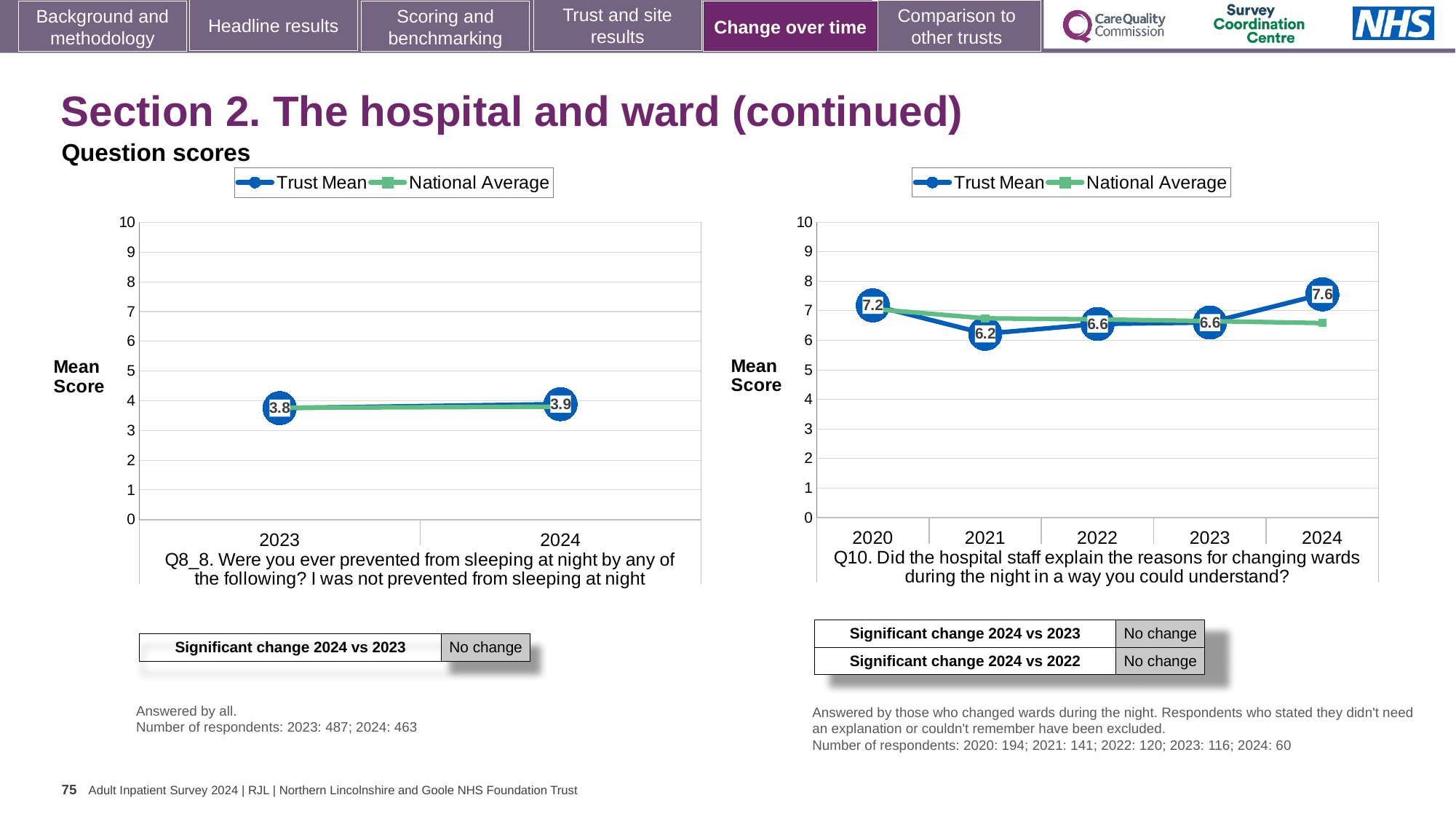
In the Q10 chart on the right, what is the Trust Mean score for 2024? 7.6 What type of chart is the Q8_8 chart on the left? Line chart In the Q10 chart on the right, which year has the highest Trust Mean score? 2024 In the Q10 chart on the right, what is the difference between the Trust Mean scores for 2024 and 2021? 1.4 In the Q8_8 chart on the left, what is the Trust Mean score for 2023? 3.8 In the Q8_8 chart on the left, how many years are plotted on the x axis? 2 In the Q8_8 chart on the left, what is the Trust Mean score for 2024? 3.9 In the Q10 chart on the right, is the Trust Mean score for 2020 or 2021 larger? 2020 In the Q10 chart on the right, how many series does the legend list? 2 In the Q10 chart on the right, what is the Trust Mean score for 2020? 7.2 In the Q10 chart on the right, what is the Trust Mean score for 2021? 6.2 In the Q10 chart on the right, which year has the lowest Trust Mean score? 2021